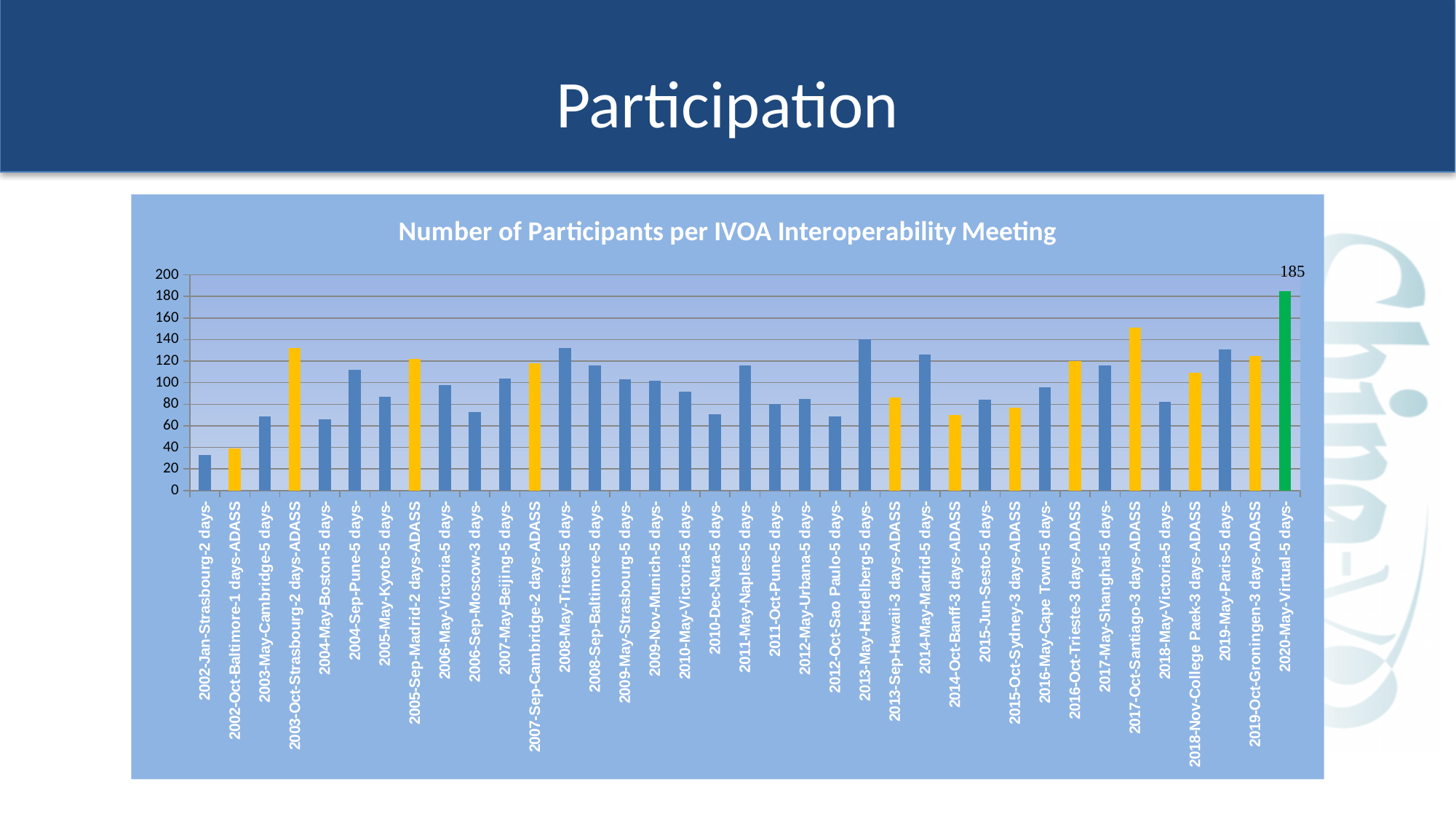
Is the value for 2004-Sep-Pune-5 days greater or less than 100? greater What is the title of the chart? Number of Participants per IVOA Interoperability Meeting What colour is the bar for 2020-May-Virtual-5 days? Green Is the value for 2014-Oct-Banff-3 days-ADASS greater or less than 80? less Which meeting has the highest number of participants? 2020-May-Virtual-5 days Which meeting has the lowest number of participants? 2002-Jan-Strasbourg-2 days Is the value for 2002-Jan-Strasbourg-2 days greater or less than 40? less How many meetings are shown on the x axis? 37 What is the number of participants for the 2020-May-Virtual-5 days meeting? 185 Which has more participants, 2003-Oct-Strasbourg-2 days-ADASS or 2004-May-Boston-5 days? 2003-Oct-Strasbourg-2 days-ADASS What kind of chart is shown on the slide? Bar chart